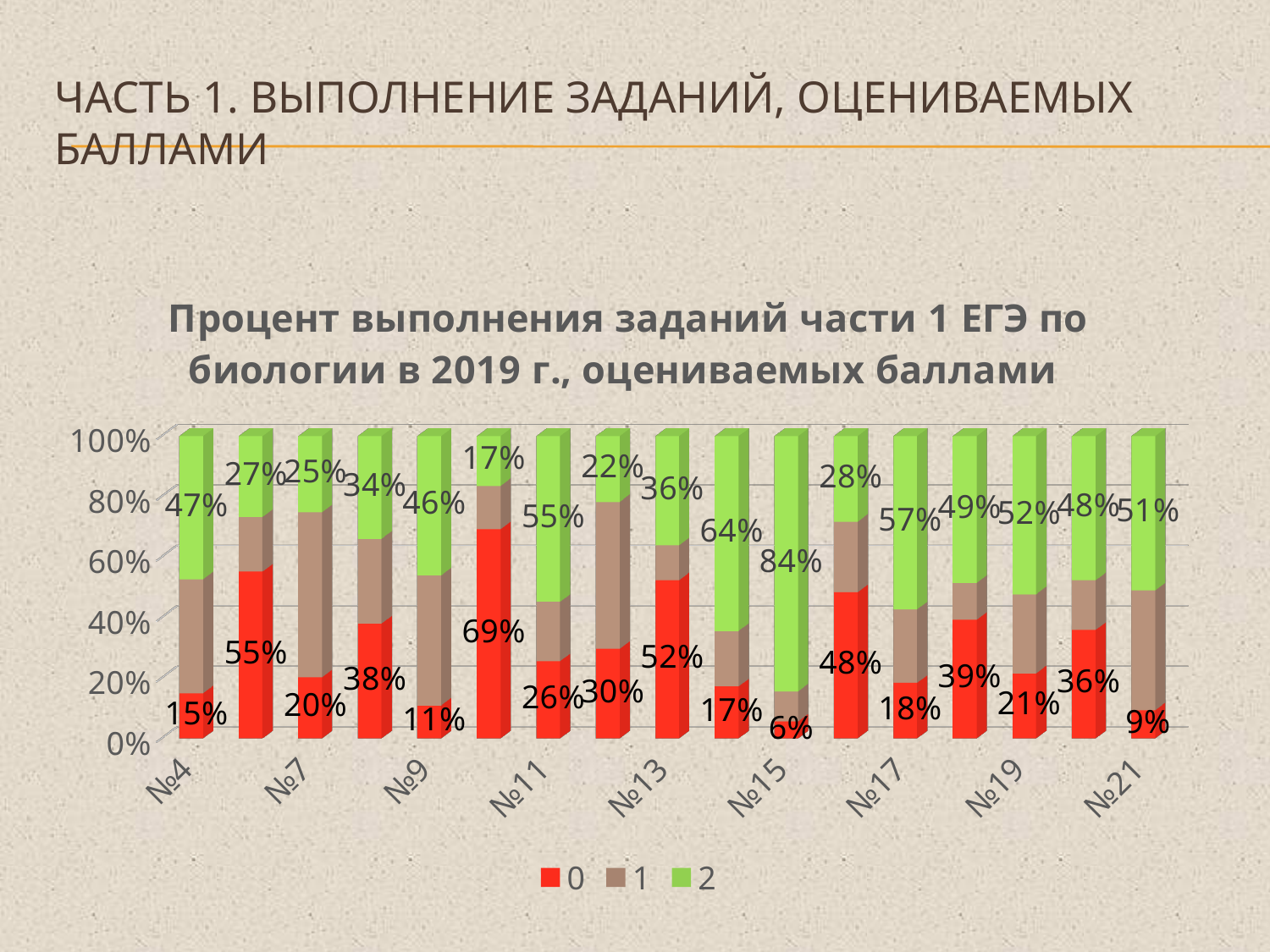
How many series does the legend list? 3 Which task has a larger share of students scoring 2 points: №11 or №13? №11 What is the value of the '0' series for task №21? 9% Is the share of students scoring 1 point on task №15 greater or less than 20%? less For task №4, how much larger is the share scoring 2 points than the share scoring 0 points? 32% Which legend entry is shown in green? 2 What percentage of students scored 2 points on task №15? 84% Among the labeled tasks, which task has the lowest share of students scoring 0 points? №15 What is the value of the '2' series for task №11? 55% Among the labeled tasks, which task has the highest share of students scoring 2 points? №15 What percentage of students scored 0 points on task №4? 15% What kind of chart is shown on the slide? Stacked bar chart